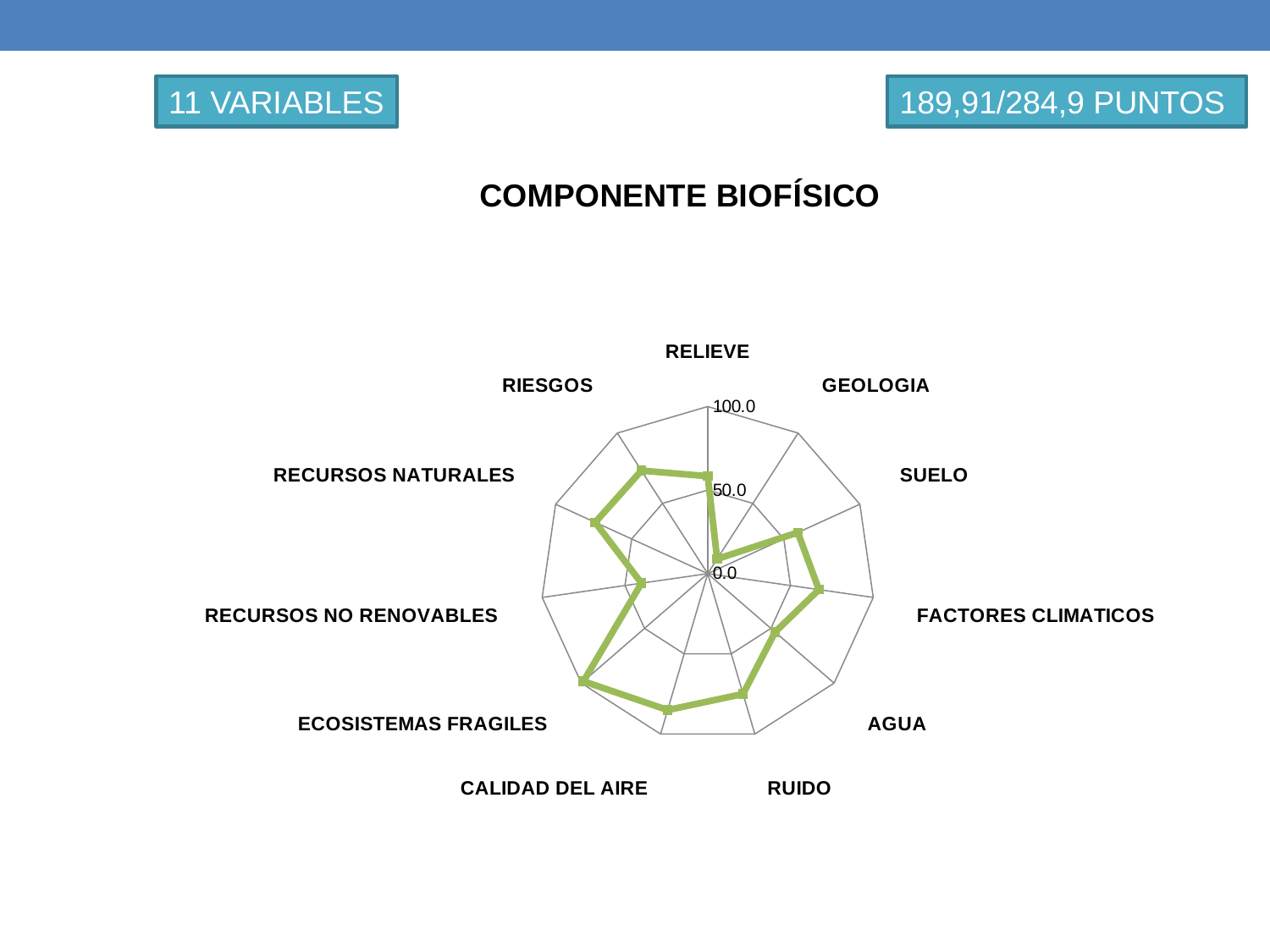
Is the value for GEOLOGIA greater or less than 50.0? less What is the maximum value shown on the radar chart's axis scale? 100.0 Is the value for CALIDAD DEL AIRE greater or less than 50.0? greater Which category has the highest value on the radar chart? ECOSISTEMAS FRAGILES What kind of chart is shown on the slide? Radar chart Is the value for ECOSISTEMAS FRAGILES greater or less than 50.0? greater How many categories (variables) are plotted on the radar chart? 11 Which has the larger value, RECURSOS NO RENOVABLES or RUIDO? RUIDO What is the title of the chart? COMPONENTE BIOFÍSICO Which has the larger value, GEOLOGIA or FACTORES CLIMATICOS? FACTORES CLIMATICOS Which category has the lowest value on the radar chart? GEOLOGIA